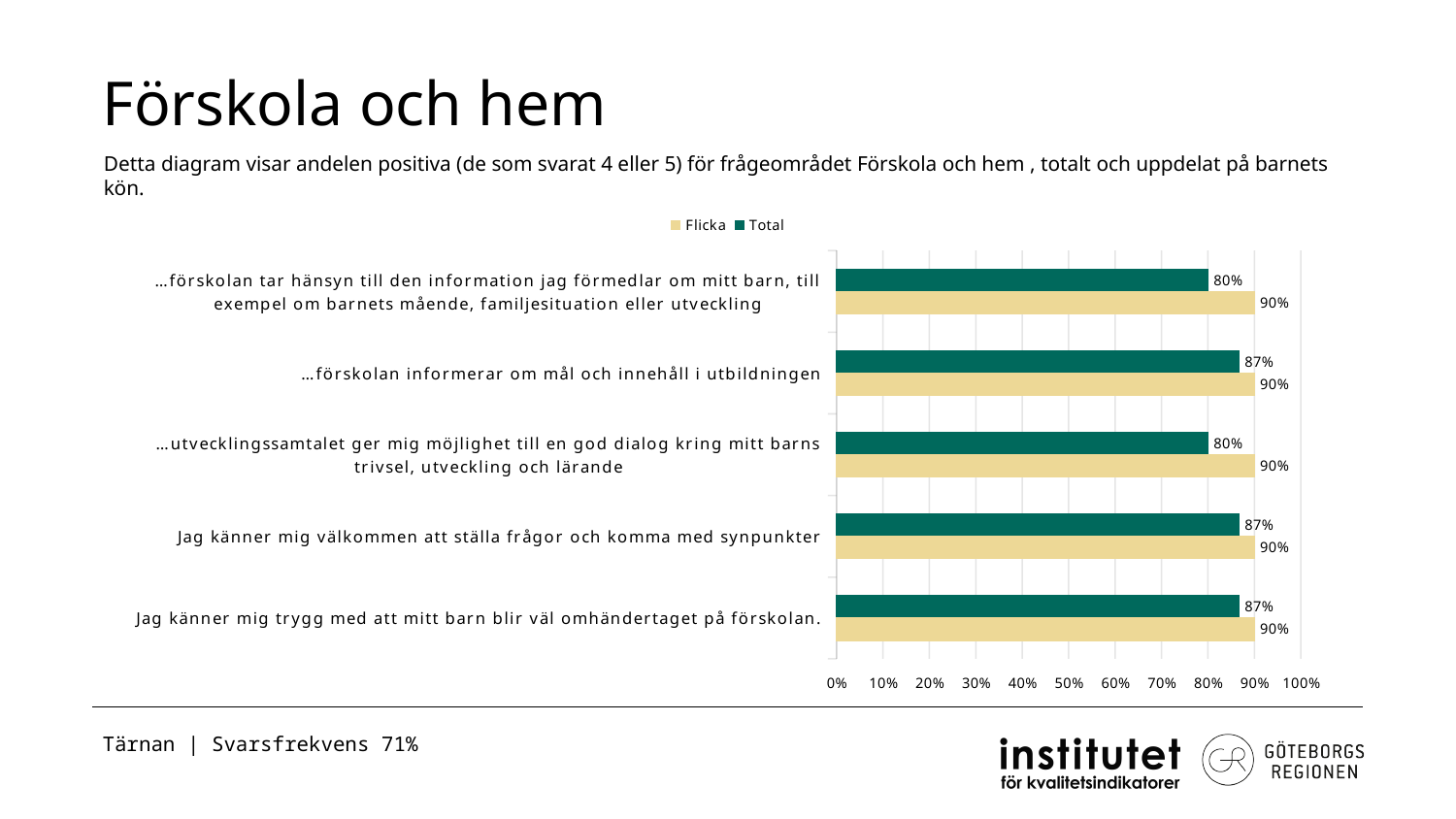
Which series is shown in green in the chart? Total What is the Total value for "Jag känner mig trygg med att mitt barn blir väl omhändertaget på förskolan."? 87% What is the Total value for "…utvecklingssamtalet ger mig möjlighet till en god dialog kring mitt barns trivsel, utveckling och lärande"? 80% What is the Flicka value for "…förskolan informerar om mål och innehåll i utbildningen"? 90% What is the difference between the Flicka and Total values for "…förskolan tar hänsyn till den information jag förmedlar om mitt barn, till exempel om barnets mående, familjesituation eller utveckling"? 10 percentage points Is the Total value for "…förskolan informerar om mål och innehåll i utbildningen" greater or less than 80%? greater How many series does the legend list? 2 What is the lowest Total value shown in the chart? 80% Which is larger for "Jag känner mig välkommen att ställa frågor och komma med synpunkter": the Flicka value or the Total value? Flicka How many categories (statements) are plotted in the chart? 5 What kind of chart is shown on the slide? bar chart What is the title of the slide containing the chart? Förskola och hem